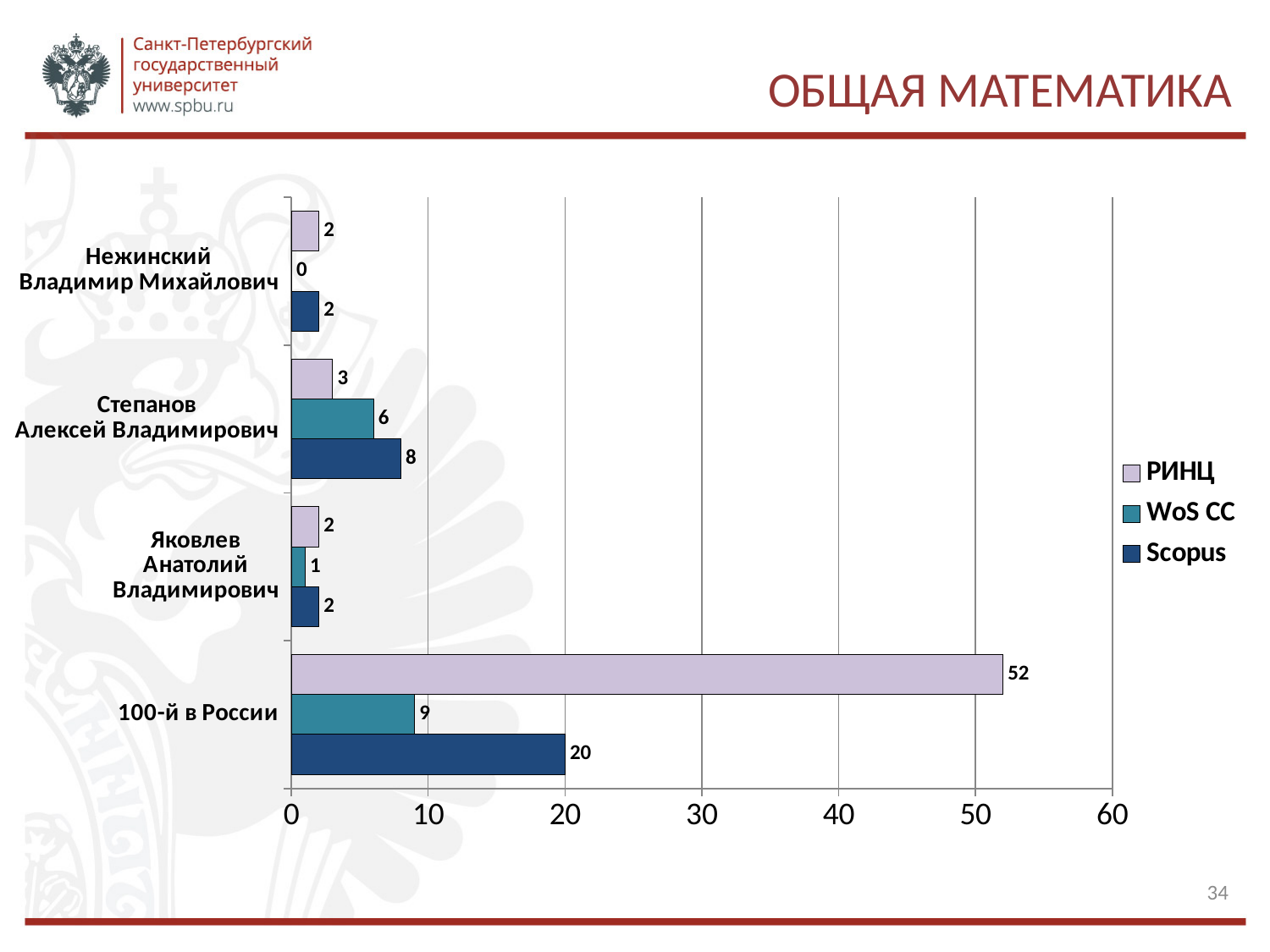
What kind of chart is shown on the slide? bar chart What is the WoS CC value for Нежинский Владимир Михайлович? 0 What is the Scopus value for Нежинский Владимир Михайлович? 2 What is the WoS CC value for Степанов Алексей Владимирович? 6 What is the difference between the Scopus value and the WoS CC value for 100-й в России? 11 Which is larger: the Scopus value for Степанов Алексей Владимирович or the Scopus value for Яковлев Анатолий Владимирович? Степанов Алексей Владимирович Which category has the highest Scopus value? 100-й в России Which category has the lowest WoS CC value? Нежинский Владимир Михайлович How many series does the legend list? 3 How many categories are shown on the chart? 4 Is the РИНЦ value for 100-й в России greater or less than 50? greater What is the РИНЦ value for 100-й в России? 52